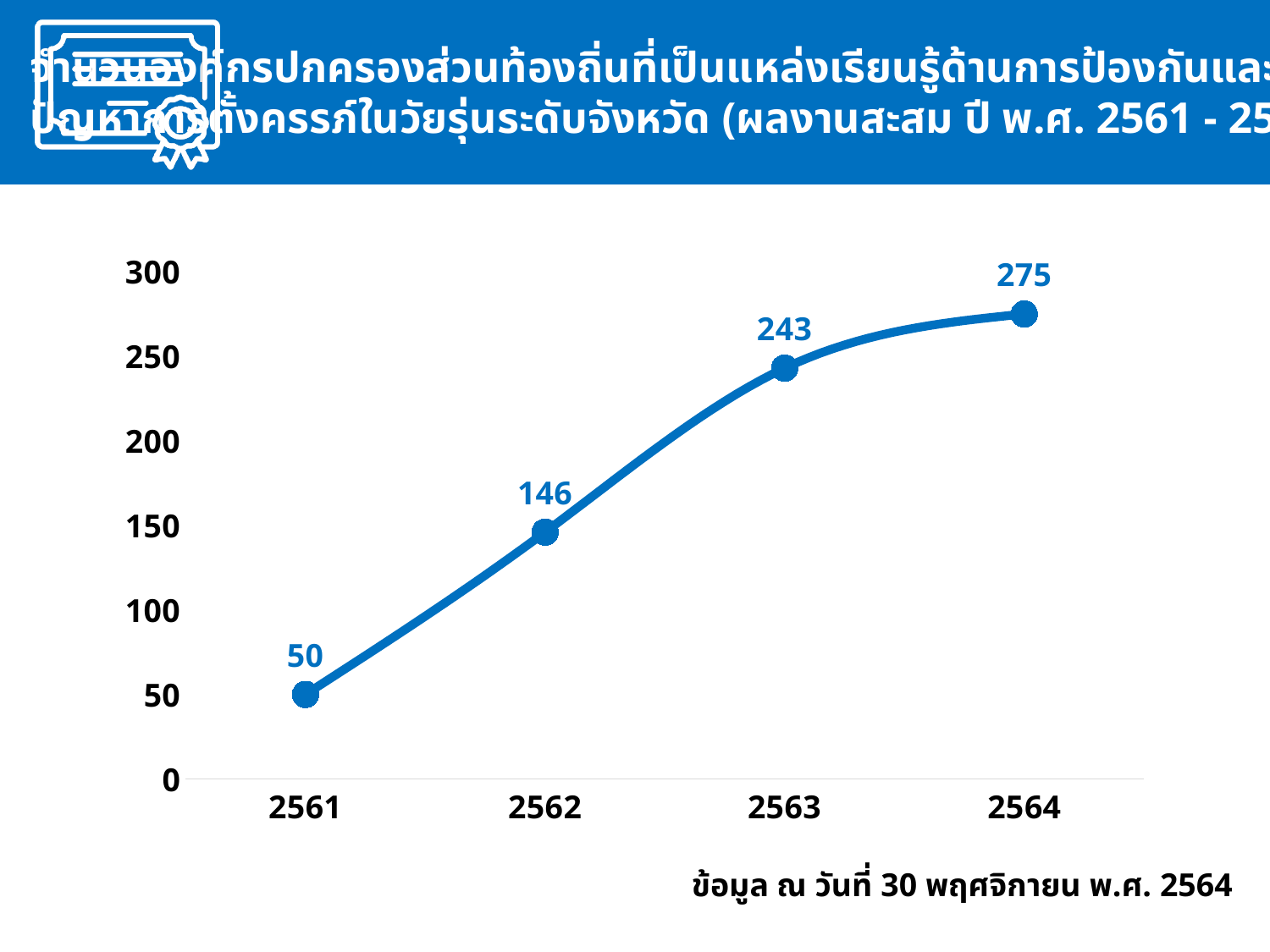
What is the value for 2562? 146 What is the value for 2561? 50 How many data points are plotted on the chart? 4 What is the value for 2563? 243 Do the values rise or fall from 2561 to 2564? rise What is the difference between the values for 2562 and 2561? 96 Which year has the highest value? 2564 What kind of chart is shown on the slide? line chart What is the difference between the values for 2564 and 2563? 32 Which year has the lowest value? 2561 What is the value for 2564? 275 Which is larger, the value for 2562 or the value for 2563? 2563